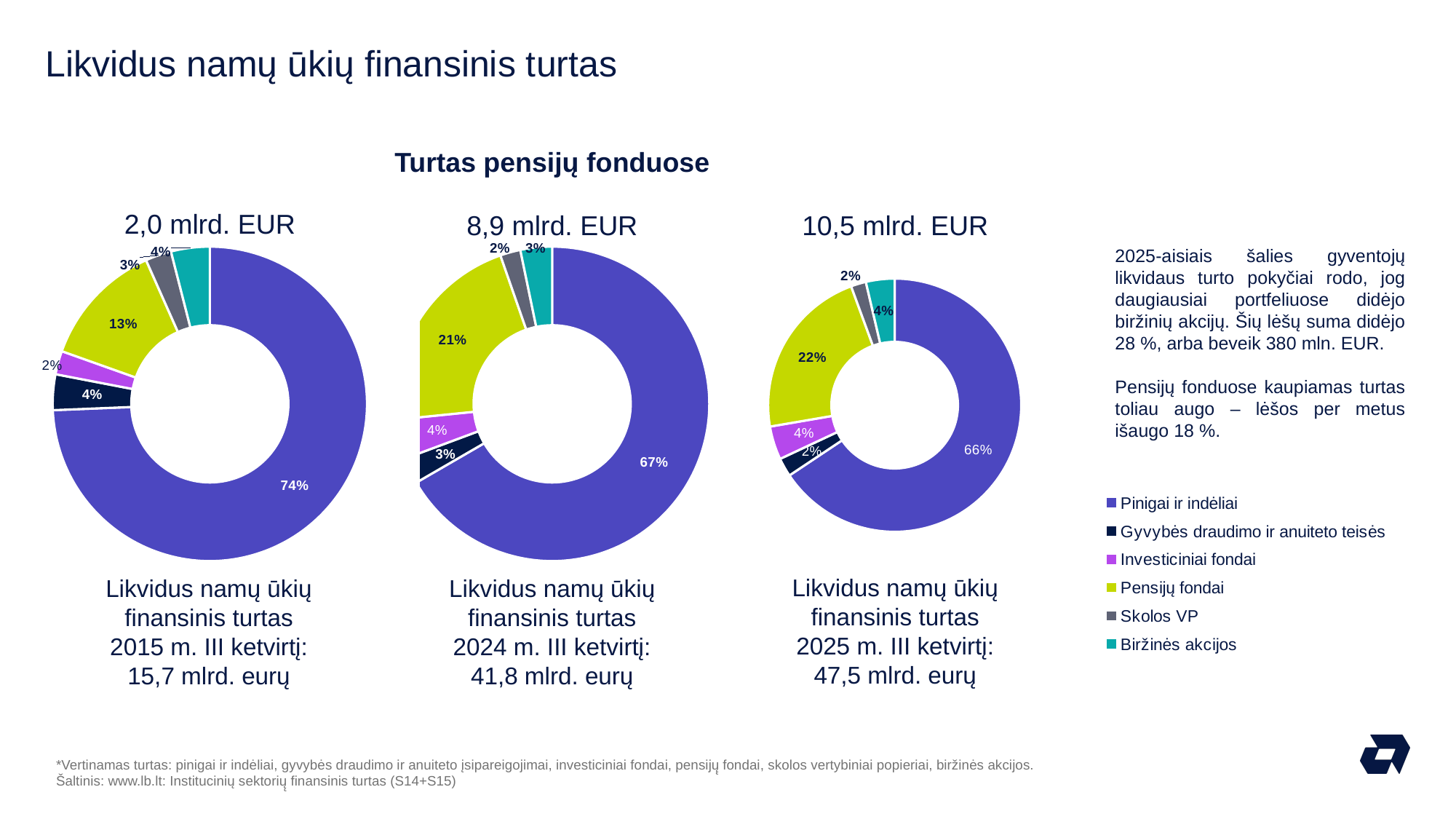
In the 2025 m. III ketvirtį chart, what share is Pinigai ir indėliai? 66% How many categories does the legend list? 6 Which is larger: the Pinigai ir indėliai share in the 2015 m. III ketvirtį chart or in the 2024 m. III ketvirtį chart? 2015 m. III ketvirtį In the 2024 m. III ketvirtį chart, which category has the smallest share? Skolos VP In the 2025 m. III ketvirtį chart, what share is Biržinės akcijos? 4% What is the difference between the Pensijų fondai share in the 2025 m. III ketvirtį chart and in the 2015 m. III ketvirtį chart? 9 percentage points In the 2015 m. III ketvirtį chart, which category has the largest share? Pinigai ir indėliai In the 2015 m. III ketvirtį chart, what share is Pinigai ir indėliai? 74% What value is shown above the 2024 m. III ketvirtį chart under the heading Turtas pensijų fonduose? 8,9 mlrd. EUR In the 2024 m. III ketvirtį chart, what share is Pensijų fondai? 21% What kind of chart is used on this slide? Pie (donut) chart What total value is shown below the 2025 m. III ketvirtį chart? 47,5 mlrd. eurų